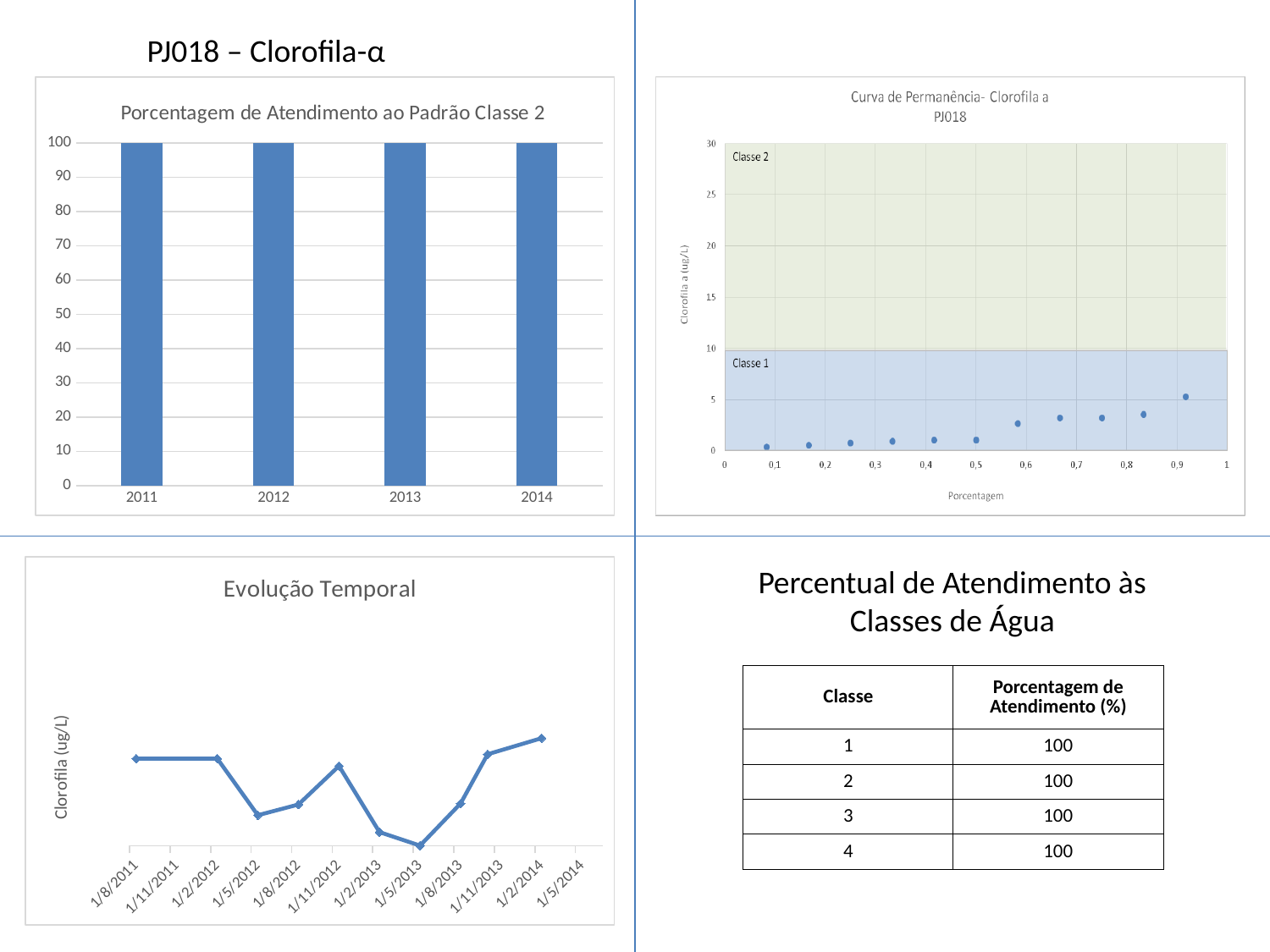
In the chart 'Evolução Temporal', which is higher: the value at 1/8/2011 or the value at 1/5/2012? 1/8/2011 In the chart 'Porcentagem de Atendimento ao Padrão Classe 2', what is the value for 2011? 100 In the chart 'Curva de Permanência - Clorofila a PJ018', is the value at Porcentagem 0,58 greater or less than 5? less In the chart 'Porcentagem de Atendimento ao Padrão Classe 2', do the values rise, fall or stay the same from 2011 to 2014? Stay the same In the chart 'Porcentagem de Atendimento ao Padrão Classe 2', what is the value for 2013? 100 In the chart 'Curva de Permanência - Clorofila a PJ018', which class label appears in the blue shaded region? Classe 1 What kind of chart is 'Porcentagem de Atendimento ao Padrão Classe 2'? Bar chart In the chart 'Curva de Permanência - Clorofila a PJ018', are all the plotted points greater or less than 10? less In the chart 'Porcentagem de Atendimento ao Padrão Classe 2', what is the difference between the values for 2012 and 2014? 0 How many years are shown in the chart 'Porcentagem de Atendimento ao Padrão Classe 2'? 4